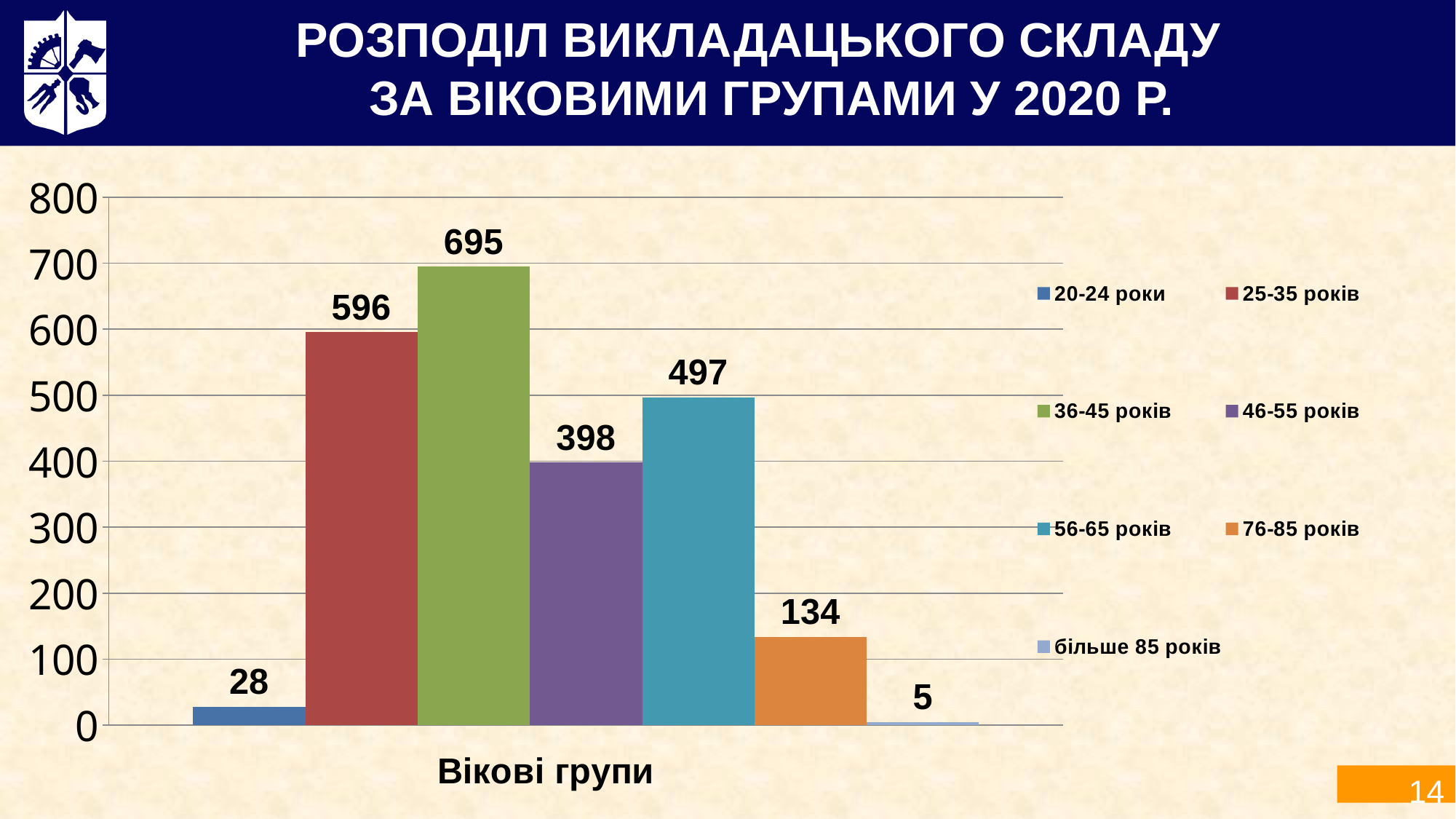
What is the value for the 36-45 років group? 695 What is the label on the horizontal axis of the chart? Вікові групи What kind of chart is shown on the slide? bar chart What is the value for the 20-24 роки group? 28 What is the difference between the values for 56-65 років and 46-55 років? 99 How many series does the legend list? 7 Which is larger, the value for 25-35 років or the value for 56-65 років? 25-35 років Which age group has the lowest value? більше 85 років What is the value for the 56-65 років group? 497 What is the difference between the values for 36-45 років and 25-35 років? 99 Which age group has the highest value? 36-45 років Is the value for 76-85 років greater or less than 200? less